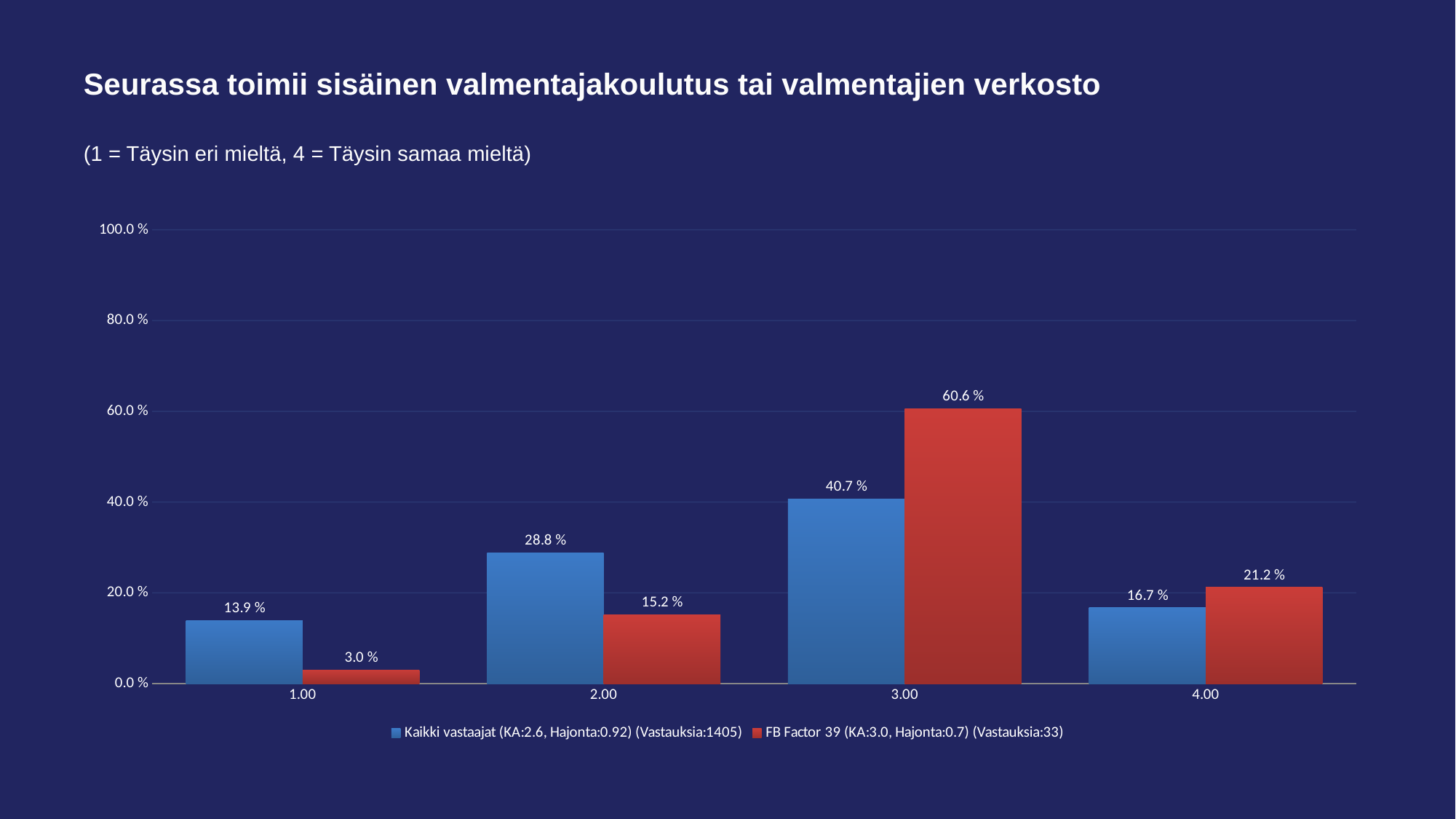
What is the value for FB Factor 39 at category 4.00? 21.2 % Is the value for FB Factor 39 at category 3.00 greater or less than 40.0 %? greater Which category has the lowest value for Kaikki vastaajat? 1.00 What is the value for FB Factor 39 at category 1.00? 3.0 % What kind of chart is shown on the slide? Bar chart Which series has the larger value at category 2.00, Kaikki vastaajat or FB Factor 39? Kaikki vastaajat What is the value for Kaikki vastaajat at category 3.00? 40.7 % How many series does the legend list? 2 How many categories are shown on the x axis? 4 Which category has the highest value for FB Factor 39? 3.00 What is the difference between FB Factor 39 and Kaikki vastaajat at category 3.00? 19.9 % What colour are the bars for the FB Factor 39 series? Red